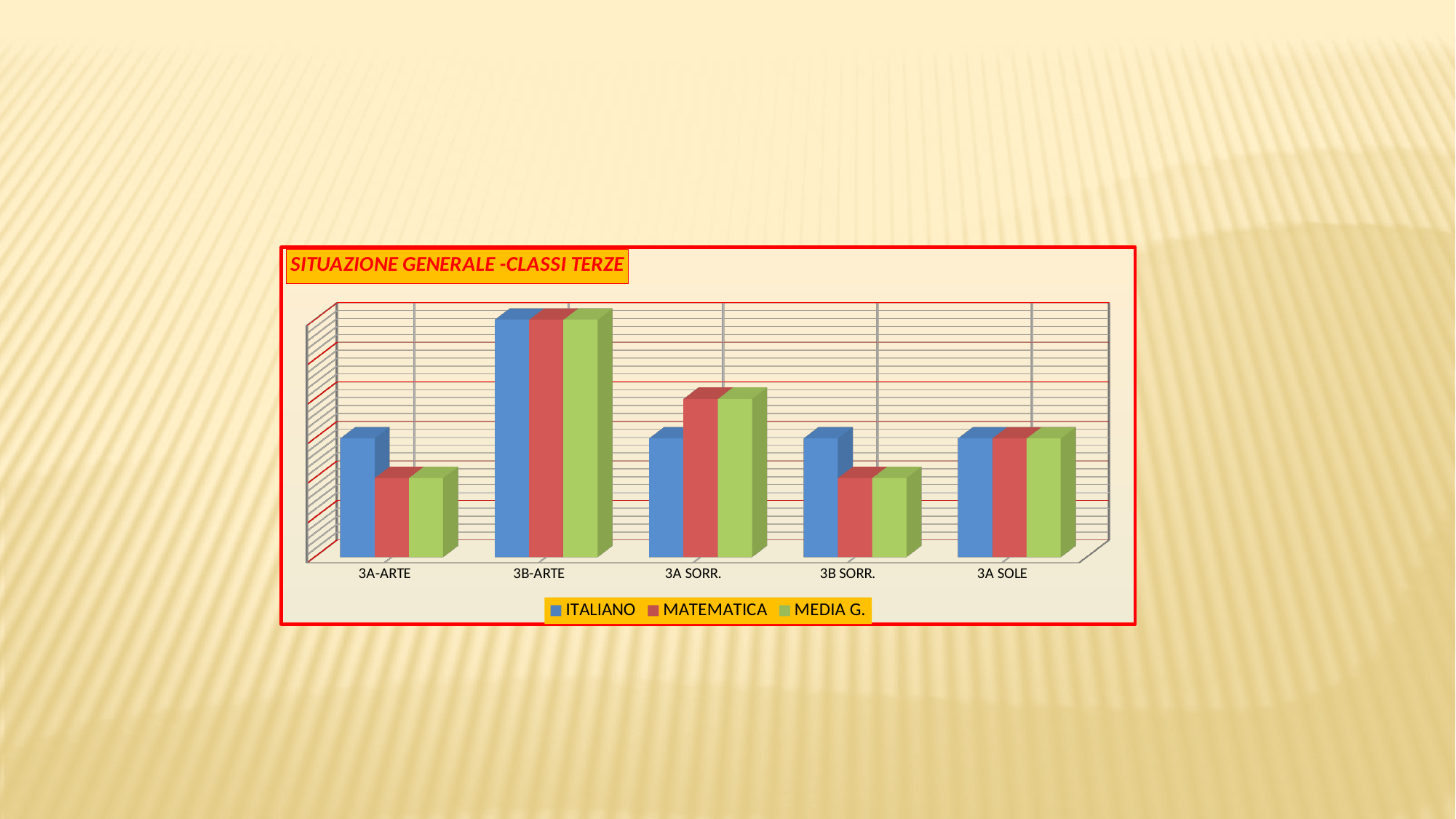
What kind of chart is shown on the slide? Bar chart Which category has the highest MEDIA G. value? 3B-ARTE How many categories are shown on the x axis? 5 Which category has the highest ITALIANO value? 3B-ARTE What is the title of the chart? SITUAZIONE GENERALE -CLASSI TERZE For 3A SORR., which is larger: ITALIANO or MATEMATICA? MATEMATICA Which category has the highest MATEMATICA value? 3B-ARTE Which has the larger ITALIANO value: 3B-ARTE or 3A SOLE? 3B-ARTE For 3A-ARTE, which is larger: ITALIANO or MATEMATICA? ITALIANO Which series is shown in green in the legend? MEDIA G. How many series does the legend list? 3